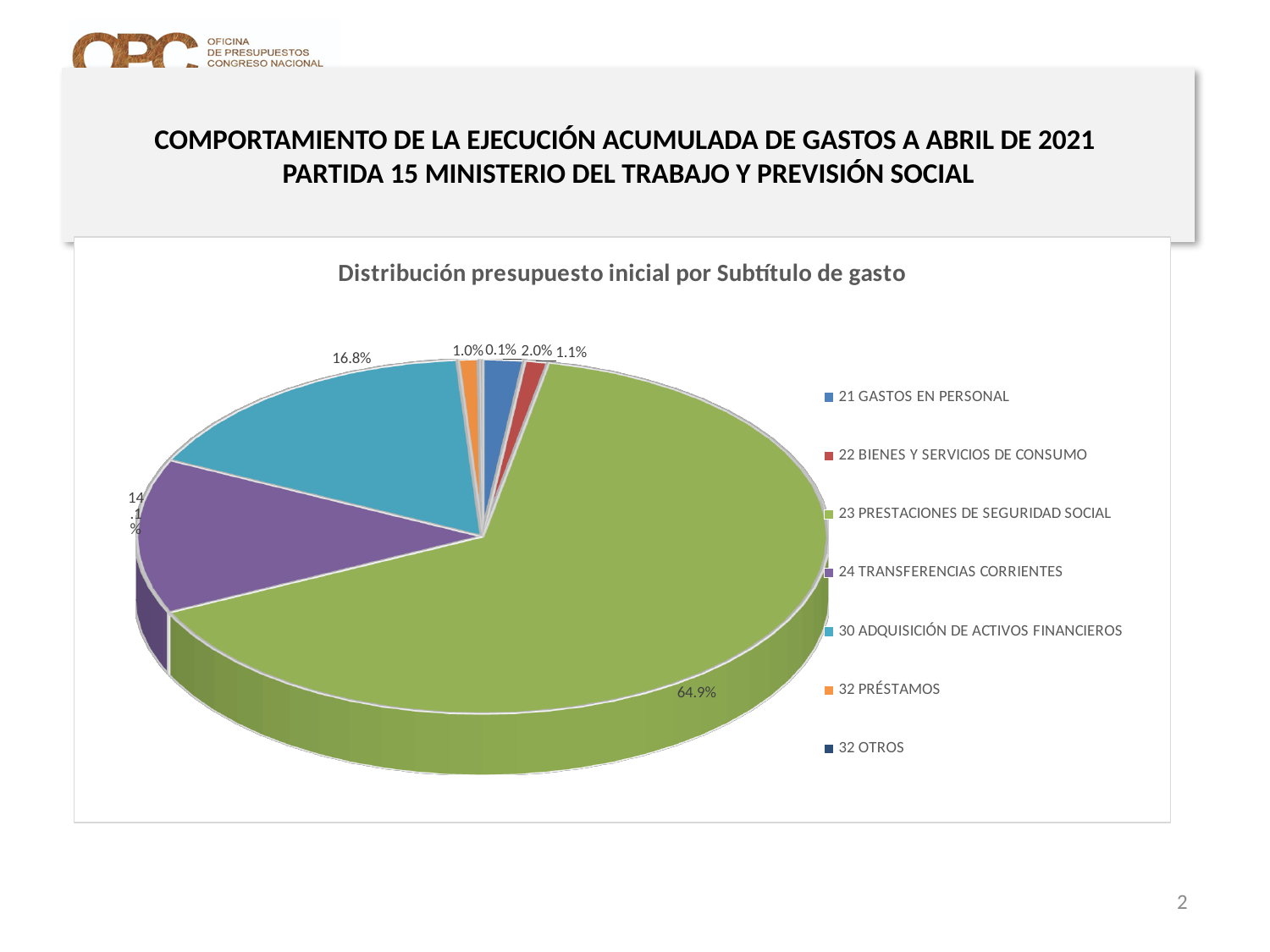
What percentage is shown for 22 BIENES Y SERVICIOS DE CONSUMO? 1.1% What percentage is shown for 30 ADQUISICIÓN DE ACTIVOS FINANCIEROS? 16.8% What percentage is shown for 21 GASTOS EN PERSONAL? 2.0% How many categories does the legend of the pie chart list? 7 Which slice is larger: 30 ADQUISICIÓN DE ACTIVOS FINANCIEROS or 24 TRANSFERENCIAS CORRIENTES? 30 ADQUISICIÓN DE ACTIVOS FINANCIEROS What kind of chart is shown on the slide? Pie chart What percentage is shown for 32 PRÉSTAMOS? 1.0% Which category has the smallest slice of the pie? 32 OTROS What share of the pie does 23 PRESTACIONES DE SEGURIDAD SOCIAL represent? 64.9% Which category has the largest slice of the pie? 23 PRESTACIONES DE SEGURIDAD SOCIAL What is the difference in percentage points between 23 PRESTACIONES DE SEGURIDAD SOCIAL and 30 ADQUISICIÓN DE ACTIVOS FINANCIEROS? 48.1 percentage points What is the title of the pie chart? Distribución presupuesto inicial por Subtítulo de gasto